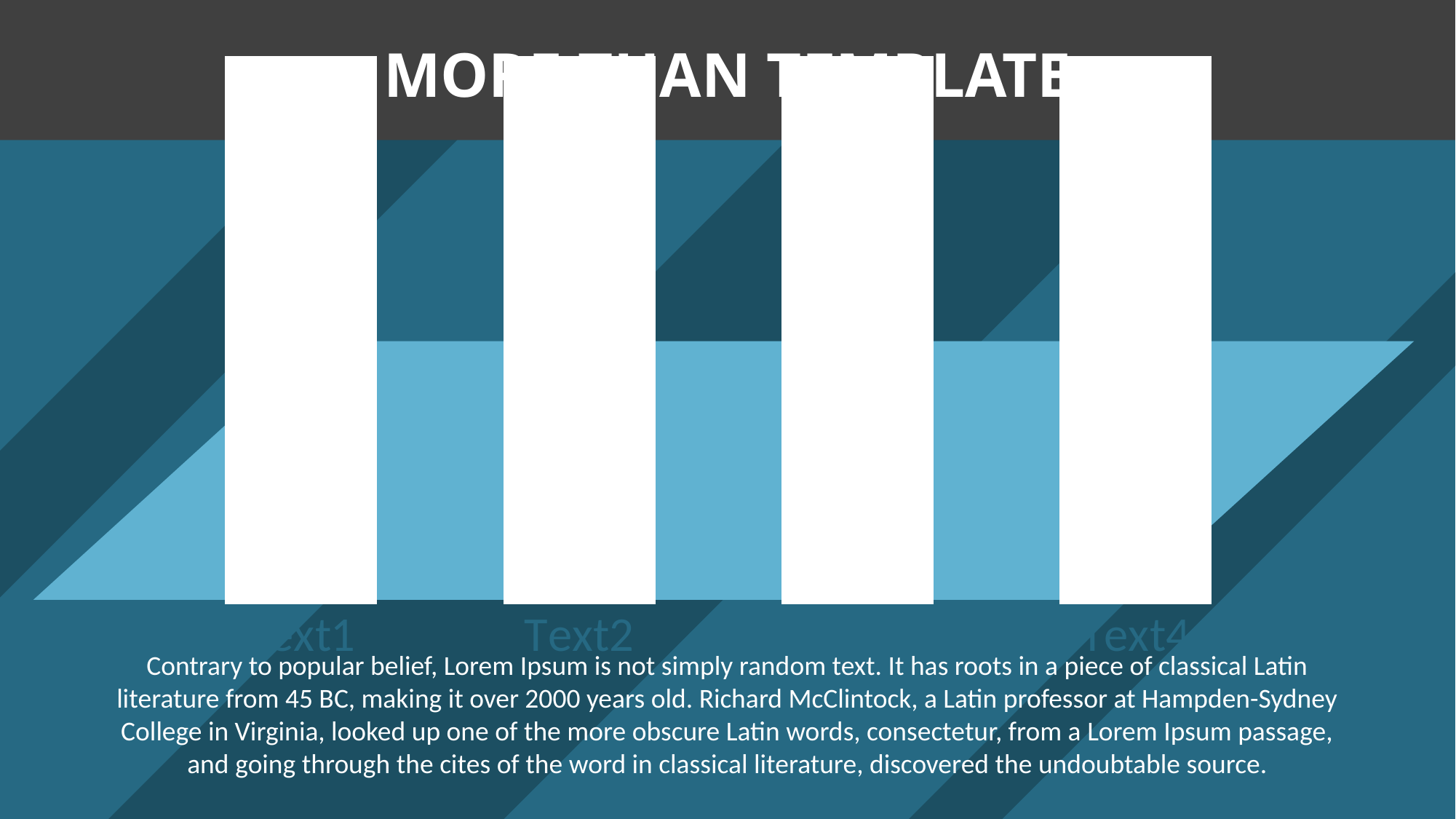
What kind of chart is shown on the slide? bar chart What is the label of the first bar on the left? Text1 How many bars does the chart have? 4 What colour are the bars in the chart? white Do the bar heights rise, fall, or stay the same from left to right? stay the same